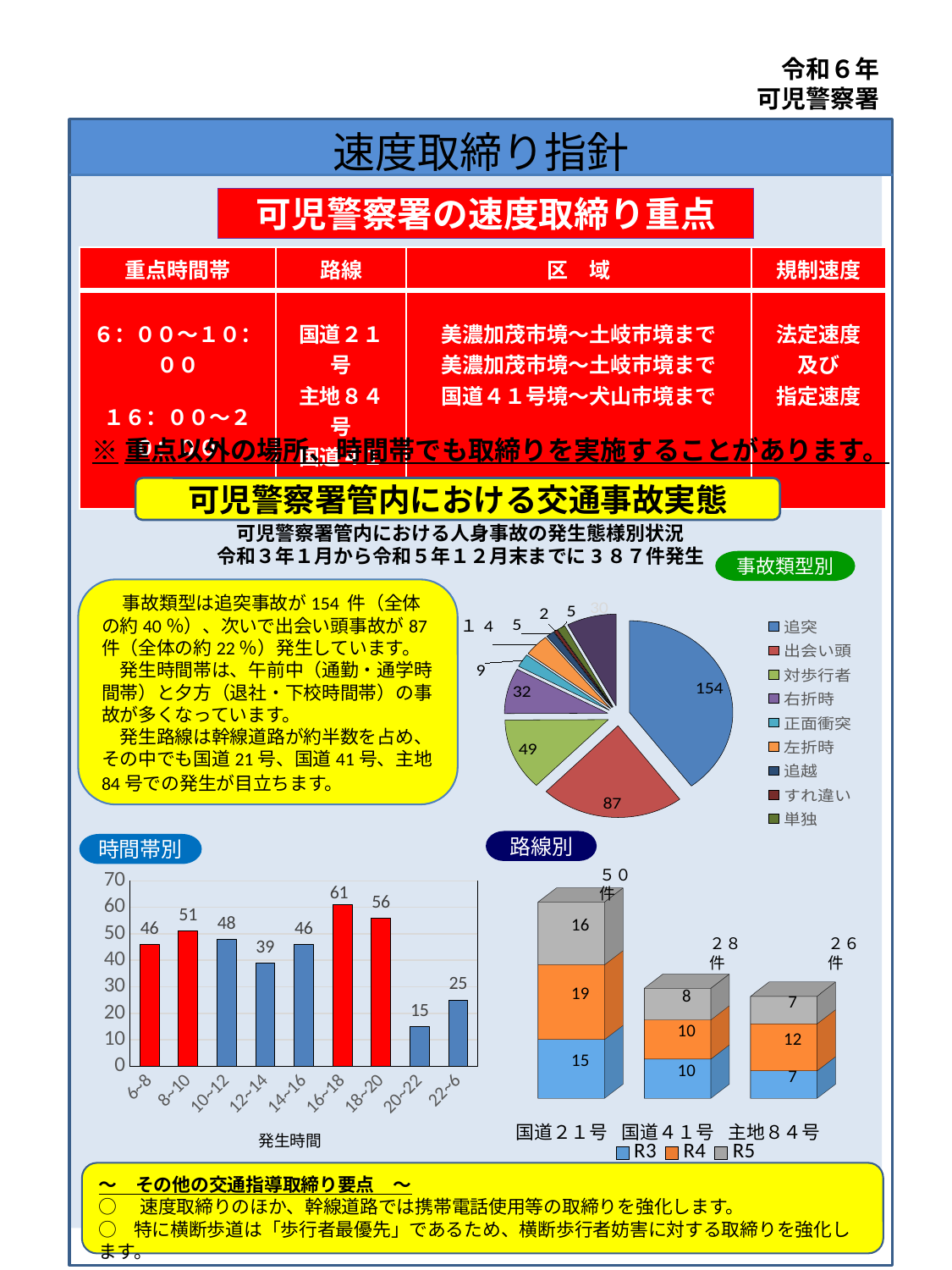
In the 路線別 stacked bar chart, what is the R4 value for 国道21号? 19 How many series does the legend of the 路線別 stacked bar chart list? 3 What type of chart is the 時間帯別 chart? bar chart In the 事故類型別 pie chart, how many accidents are shown for 追突? 154 In the 路線別 stacked bar chart, what is the total for 国道41号? 28件 In the 事故類型別 pie chart, which category has the largest slice? 追突 In the 時間帯別 bar chart, how many time bands are shown on the x axis? 9 In the 時間帯別 bar chart, which is larger, the value for 8~10 or the value for 12~14? 8~10 In the 時間帯別 bar chart, which time band has the lowest value? 20~22 In the 事故類型別 pie chart, what is the difference between the 出会い頭 value and the 対歩行者 value? 38 How many entries does the legend of the 事故類型別 pie chart list? 9 In the 時間帯別 bar chart, what is the value for the 16~18 time band? 61